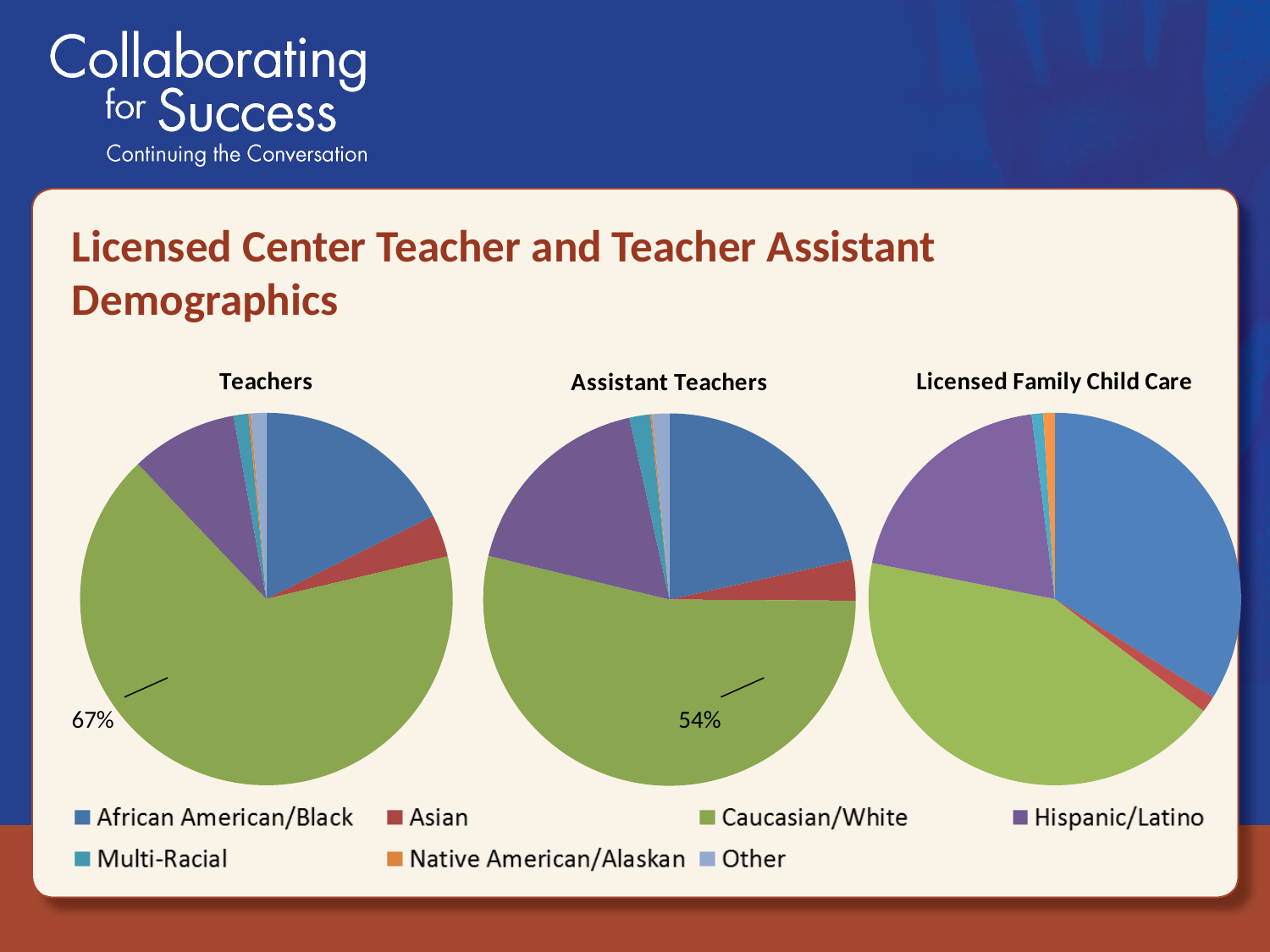
Which chart has the larger Caucasian/White share, Teachers or Assistant Teachers? Teachers In the Assistant Teachers pie chart, which category has the largest slice? Caucasian/White What is the title of the third pie chart on the slide? Licensed Family Child Care In the Teachers pie chart, which category has the largest slice? Caucasian/White In the Teachers pie chart, which slice is larger, African American/Black or Asian? African American/Black What is the difference between the Caucasian/White share in the Teachers chart and in the Assistant Teachers chart? 13 percentage points In the Assistant Teachers pie chart, what share is Caucasian/White? 54% How many pie charts are on the slide? 3 In the Teachers pie chart, what share is Caucasian/White? 67% In the Licensed Family Child Care pie chart, which slice is larger, Hispanic/Latino or Asian? Hispanic/Latino How many categories does the legend list? 7 What kind of charts are shown on the slide? Pie charts